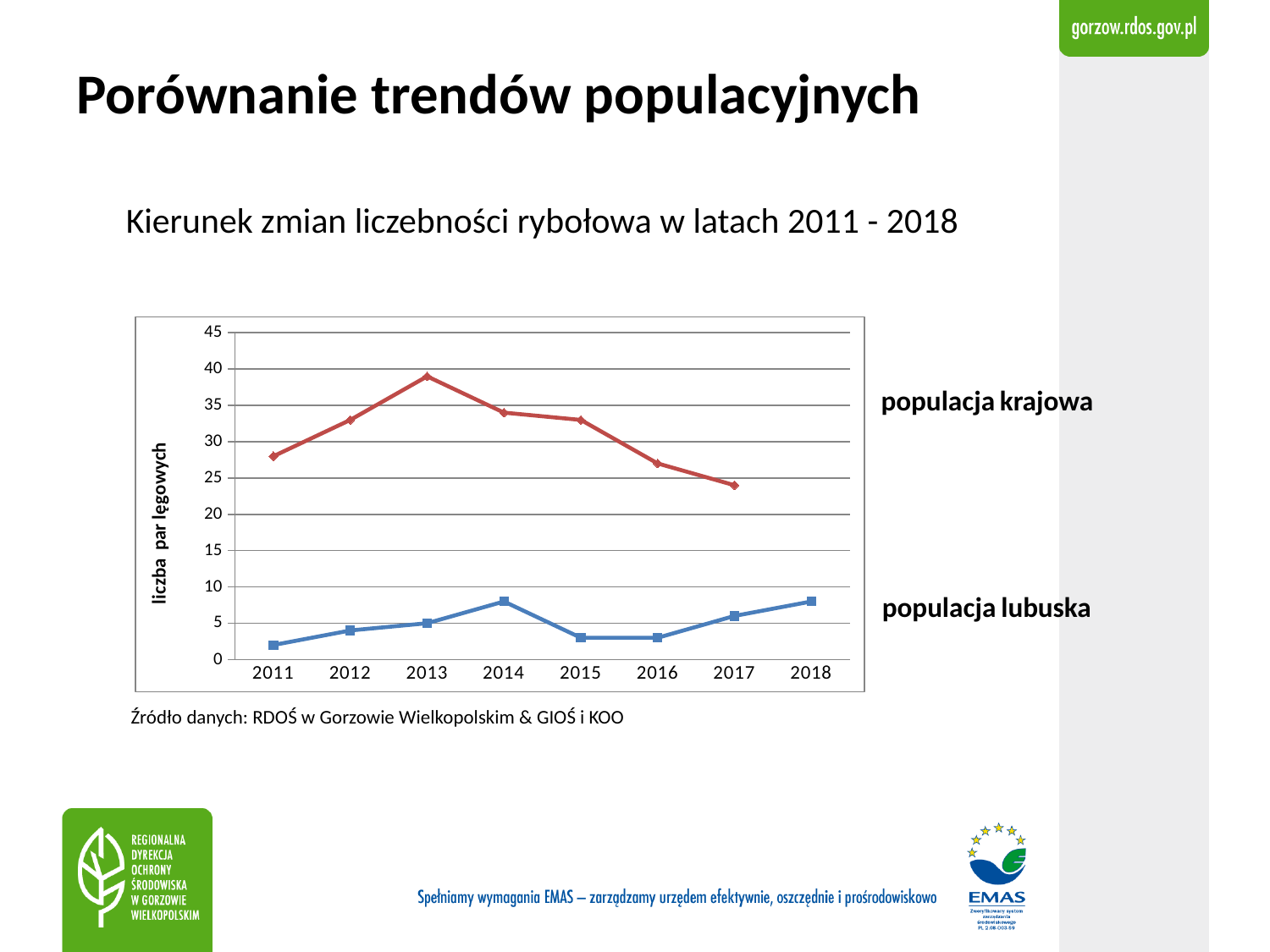
How many data series are plotted in the chart? 2 Does the populacja krajowa series rise or fall between 2013 and 2017? fall Is the value for populacja lubuska in 2014 greater or less than 10? less What is the label on the vertical axis of the chart? liczba par lęgowych In which year does the populacja krajowa series reach its lowest value? 2017 Is the value for populacja krajowa in 2011 greater or less than 30? less What kind of chart is shown on the slide? line chart Is the value for populacja krajowa in 2013 greater or less than 35? greater How many years are shown on the x axis of the chart? 8 Which is larger for populacja krajowa: the value in 2012 or the value in 2016? 2012 In which year does the populacja krajowa series reach its highest value? 2013 Which is larger for populacja lubuska: the value in 2014 or the value in 2015? 2014